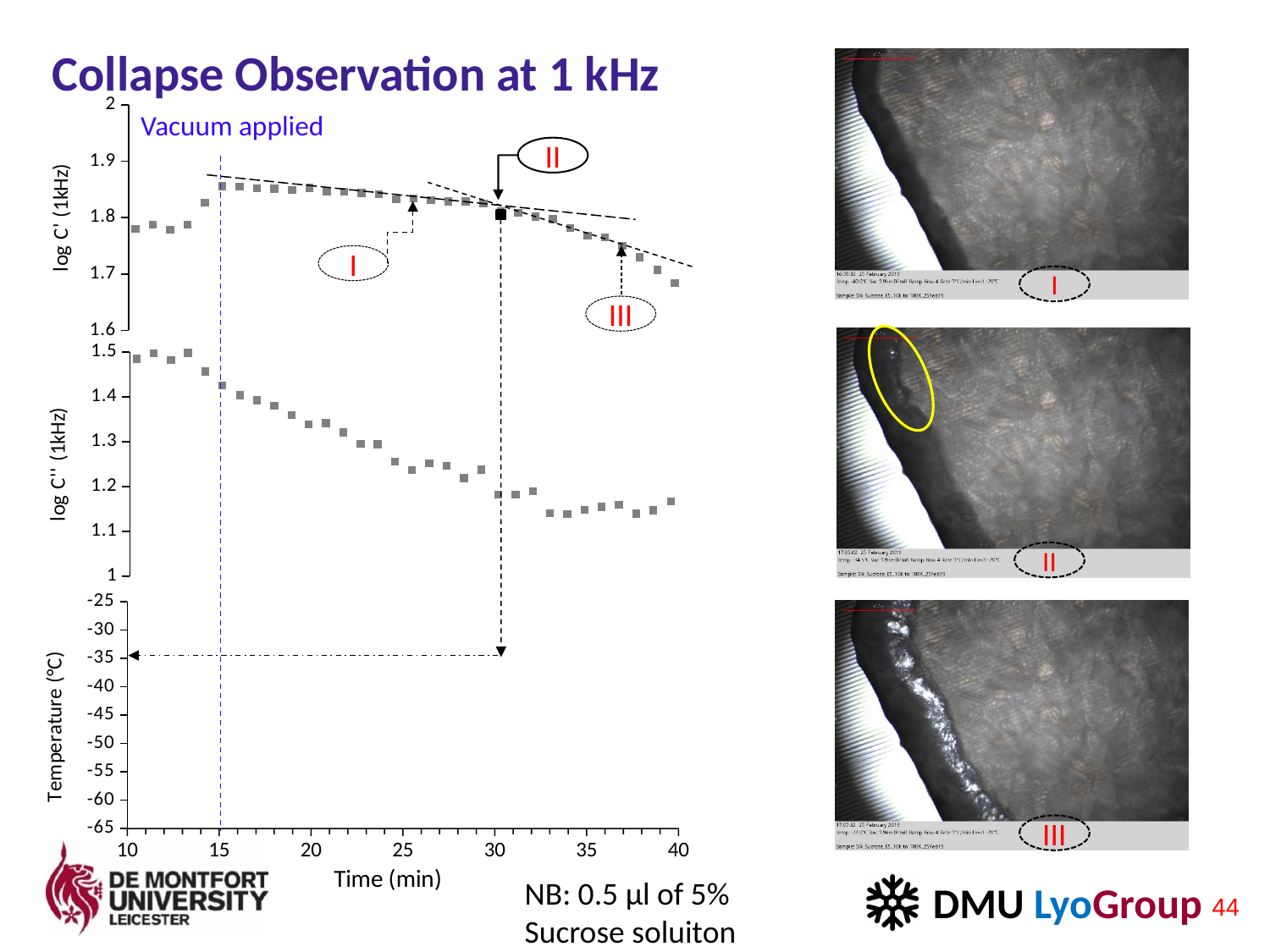
What temperature on the Temperature (°C) axis does the horizontal dash-dot arrow from point II point to? -35 Which is larger, the log C' (1kHz) value at 15 min or at 40 min? 15 min Is the log C'' (1kHz) value at 10 min greater or less than 1.4? greater How many stacked panels (y axes) does the chart have? 3 What kind of chart is shown on the slide? scatter chart Is the log C' (1kHz) value at 35 min greater or less than 1.8? less Is the log C'' (1kHz) value at 35 min greater or less than 1.2? less At what time on the x axis is the vertical dashed line labelled 'Vacuum applied' drawn? 15 What is the title of the x axis of the chart? Time (min) Does log C'' (1kHz) rise or fall as time increases from 10 min to 35 min? fall